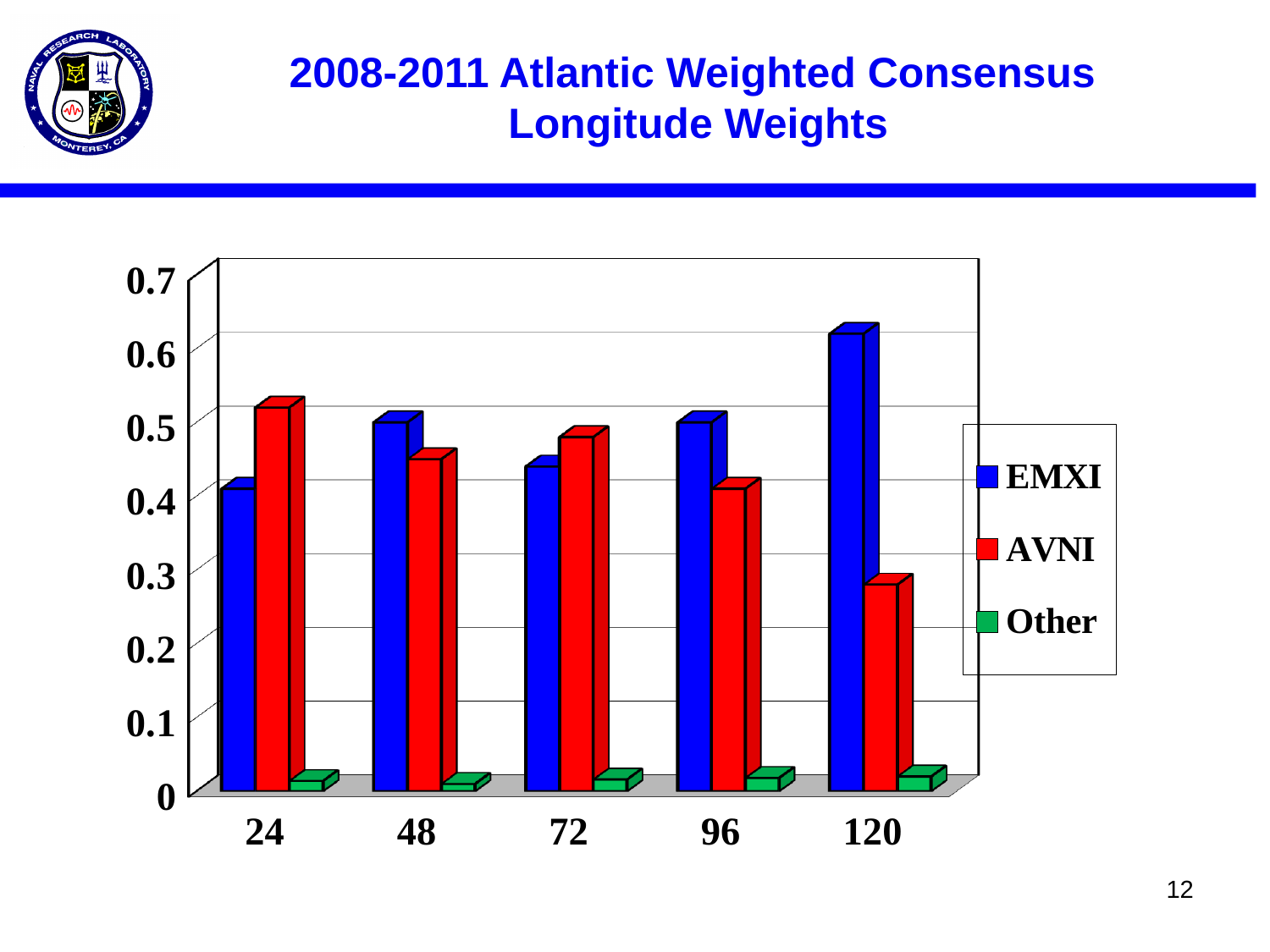
At which forecast hour is the AVNI weight lowest? 120 At 120 hours, which series has the larger weight, EMXI or AVNI? EMXI How many series does the legend list? 3 Is the Other weight at 24 hours greater or less than 0.1? less How many forecast-hour categories are shown on the x axis? 5 What kind of chart is shown on the slide? bar chart At which forecast hour is the AVNI weight highest? 24 Is the AVNI weight at 120 hours greater or less than 0.4? less Is the EMXI weight at 120 hours greater or less than 0.5? greater At which forecast hour is the EMXI weight highest? 120 Which colour represents the EMXI series in the legend? blue At 24 hours, which series has the larger weight, EMXI or AVNI? AVNI